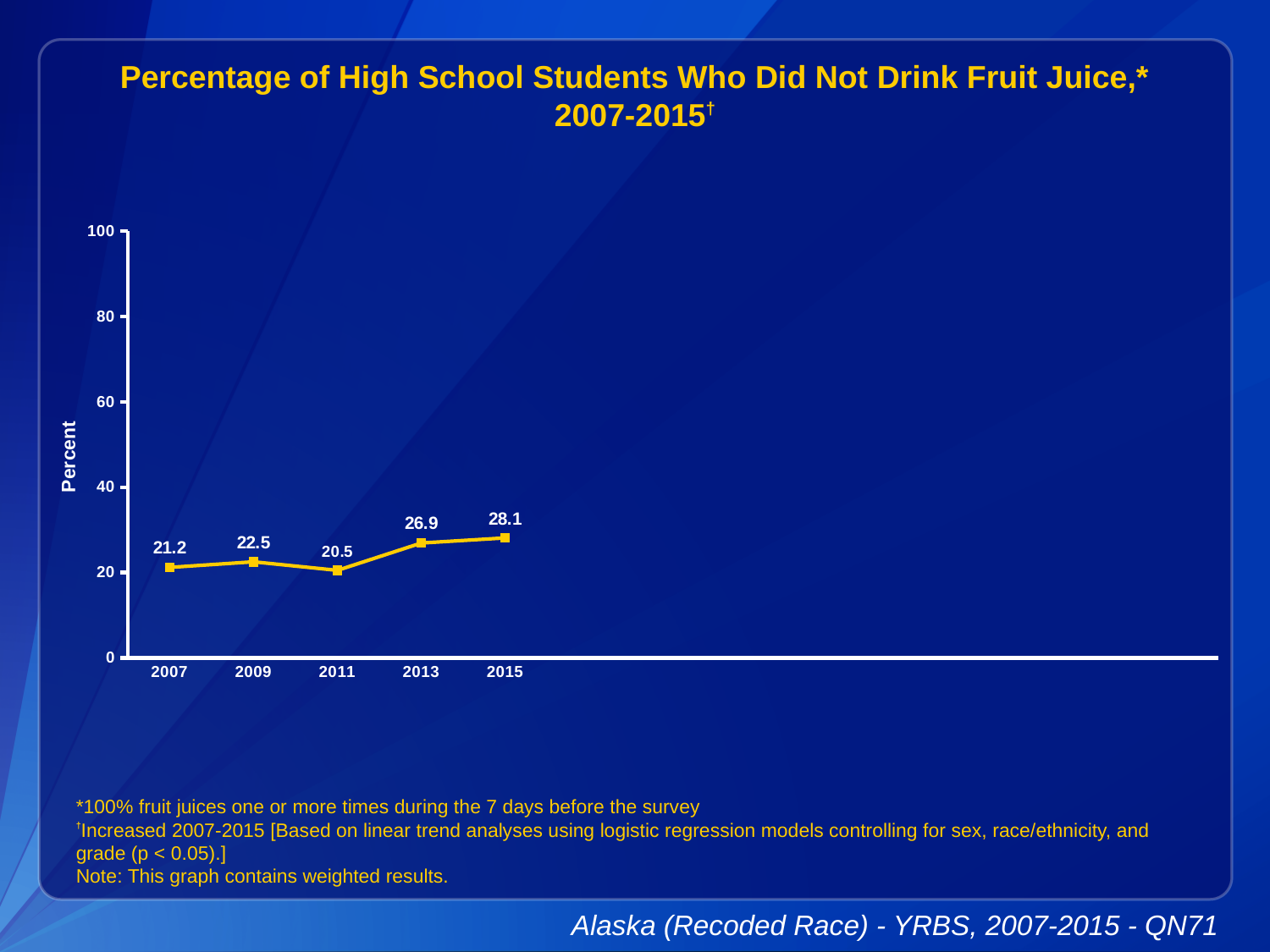
Which year has the highest value? 2015 Which is larger, the value for 2009 or the value for 2013? 2013 What is the label on the y axis? Percent Which year has the lowest value? 2011 What is the value for 2011? 20.5 Do the values generally rise or fall from 2007 to 2015? rise What is the value for 2007? 21.2 What kind of chart is shown on the slide? line chart Is the value for 2013 greater or less than 40? less How many years are plotted on the chart? 5 What is the difference between the values for 2015 and 2007? 6.9 What is the value for 2015? 28.1